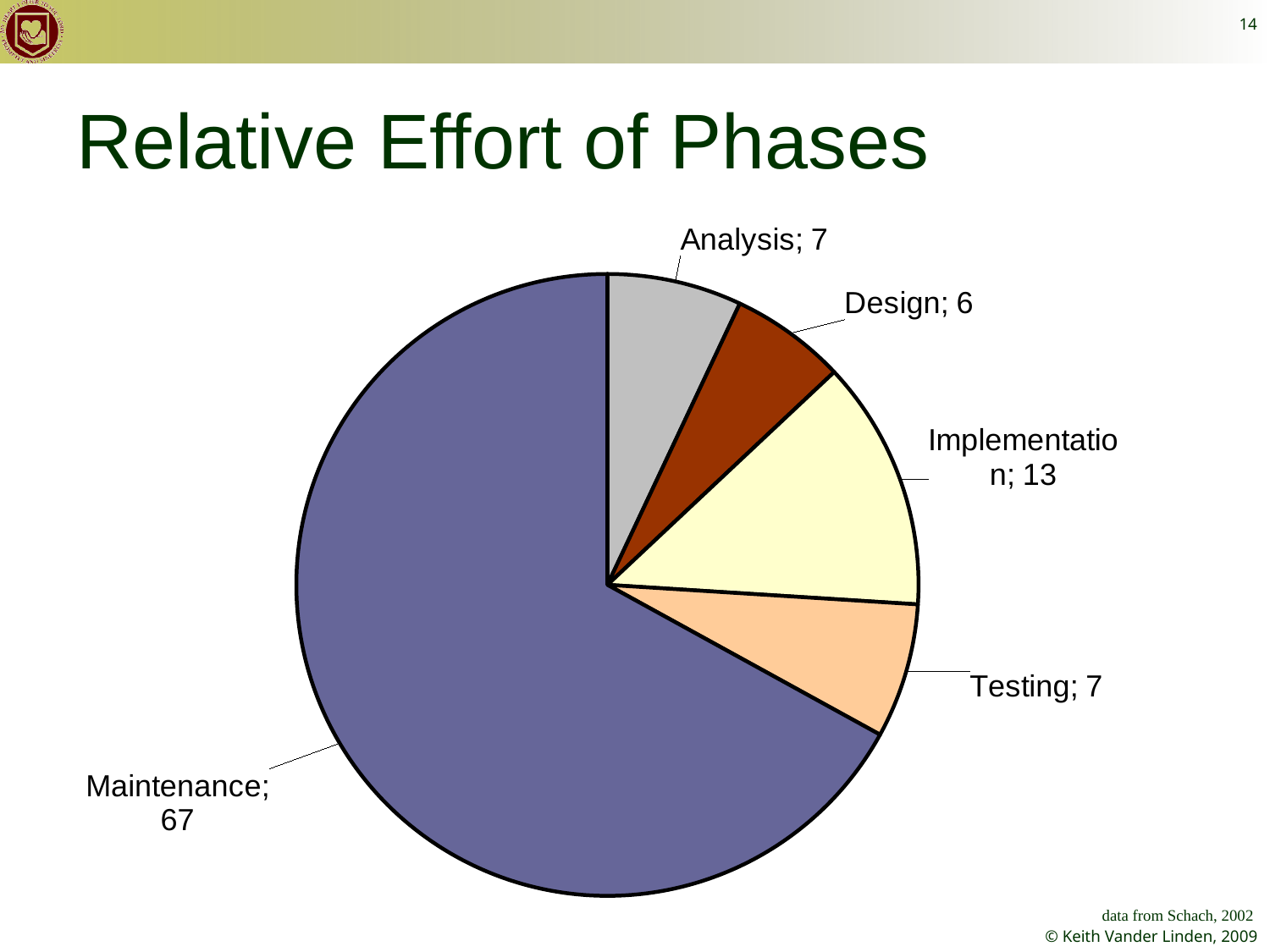
What is the value for Design? 6 Which phase has the largest slice of the pie? Maintenance Which is larger, the value for Implementation or the value for Testing? Implementation What is the value for Analysis? 7 What is the value for Implementation? 13 What type of chart is shown on the slide? pie chart How many slices does the pie chart have? 5 What is the value for Maintenance? 67 What is the difference between the values for Maintenance and Implementation? 54 Which phase has the smallest slice of the pie? Design What share of the pie does Maintenance represent? 67% What is the title of the slide containing the chart? Relative Effort of Phases